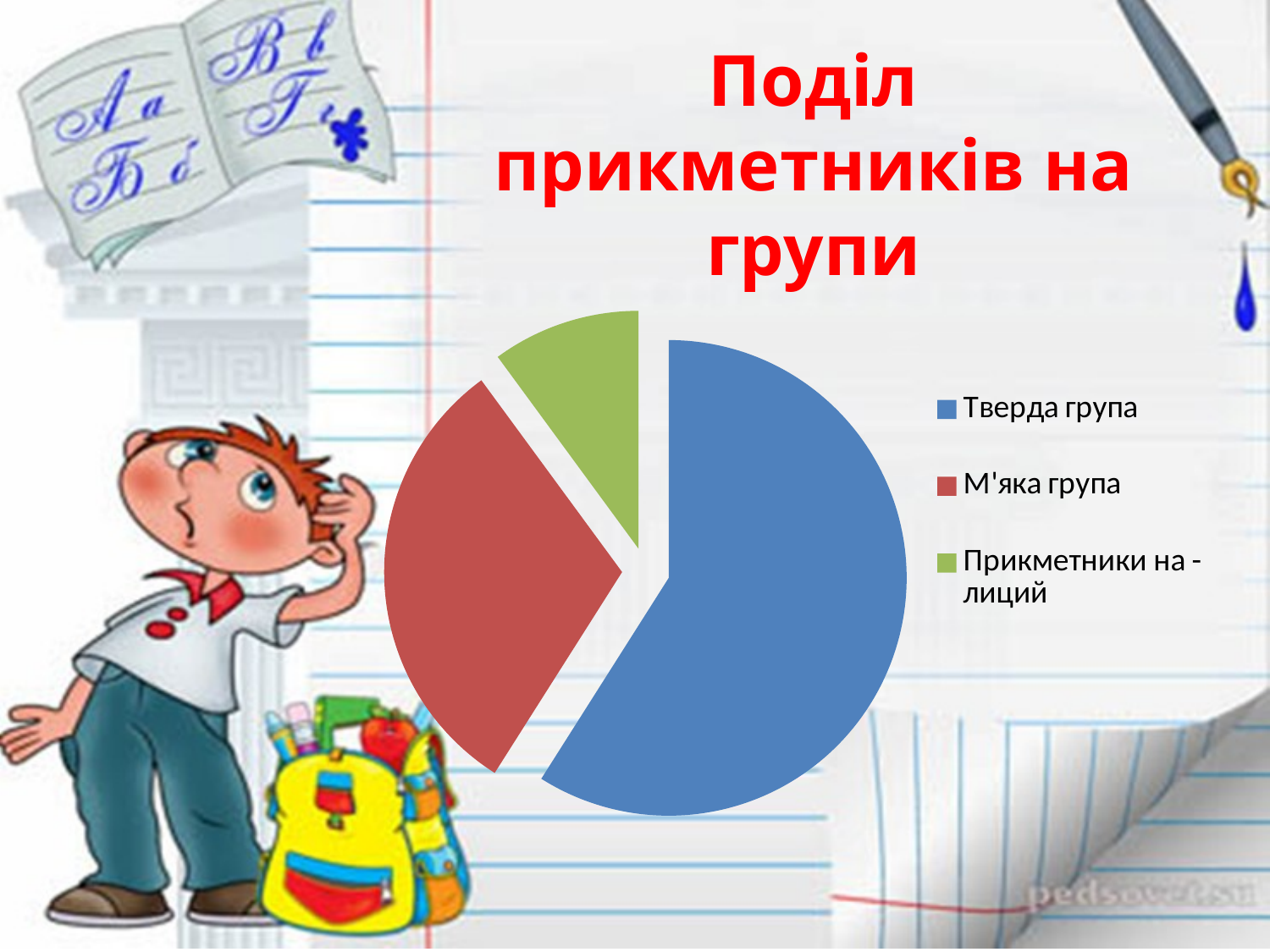
Which category has the smallest slice of the pie chart? Прикметники на -лиций What colour is the slice for М'яка група in the pie chart? red How many entries does the legend of the pie chart list? 3 Which category has the largest slice of the pie chart? Тверда група How many slices does the pie chart have? 3 Does the slice for Тверда група take up more or less than half of the pie? more What kind of chart is shown on the slide? pie chart Which slice is larger: Тверда група or М'яка група? Тверда група What is the title of the slide with the pie chart? Поділ прикметників на групи Which slice is larger: М'яка група or Прикметники на -лиций? М'яка група